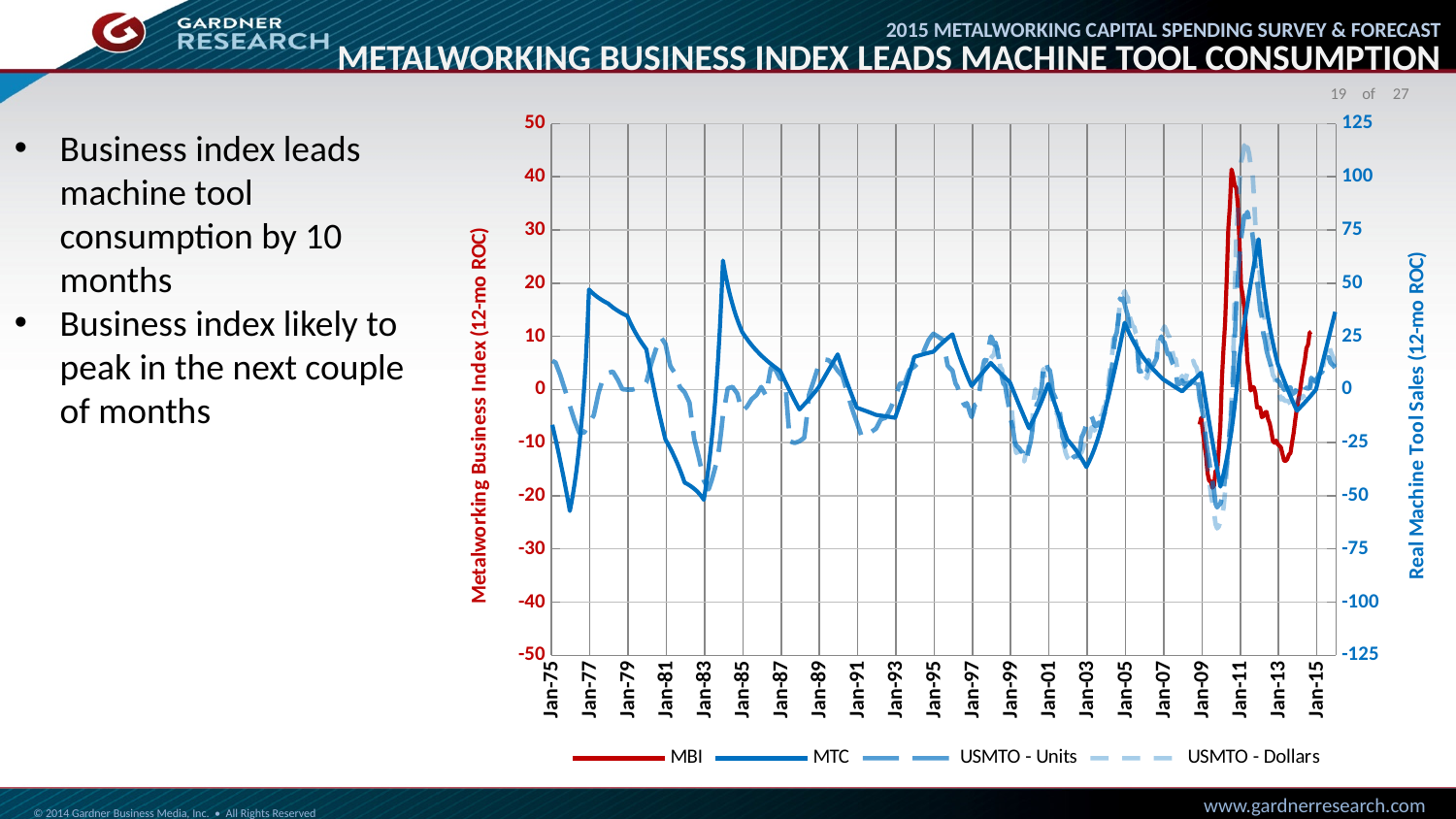
Which series is drawn in red on the chart? MBI Does the MBI series rise or fall between Jan-13 and Jan-15? rise What is the title of the left vertical axis? Metalworking Business Index (12-mo ROC) How many year labels are shown along the x axis? 21 Is the MTC value at its peak around Jan-85 greater or less than 20 on the left axis? greater Is the MBI value at its trough around Jan-09 greater or less than -10 on the left axis? less Is the peak value of the MBI series around Jan-11 greater or less than 30 on the left axis? greater How many series does the chart legend list? 4 What kind of chart is shown on the slide? line chart